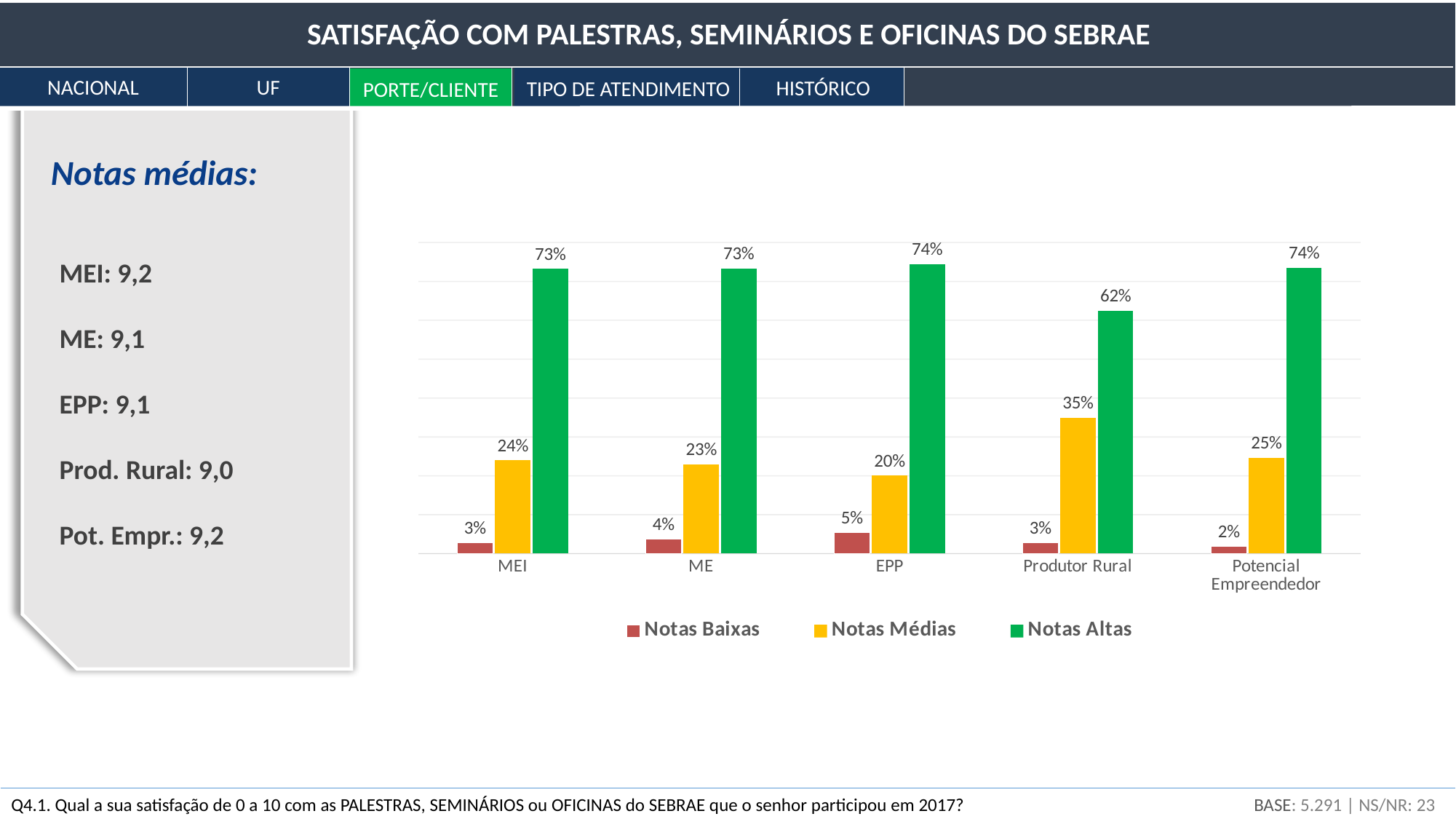
How many series does the legend list? 3 What is the Notas Altas value for Produtor Rural? 62% How many categories are shown on the x axis? 5 Which category has the lowest Notas Altas value? Produtor Rural What is the Notas Médias value for EPP? 20% Which is larger, the Notas Médias value for MEI or for ME? MEI Which category has the highest Notas Médias value? Produtor Rural Which category has the highest Notas Baixas value? EPP What is the Notas Baixas value for Potencial Empreendedor? 2% What kind of chart is shown on the slide? Bar chart What is the difference between the Notas Altas values for EPP and Produtor Rural? 12% What colour represents the Notas Altas series? Green